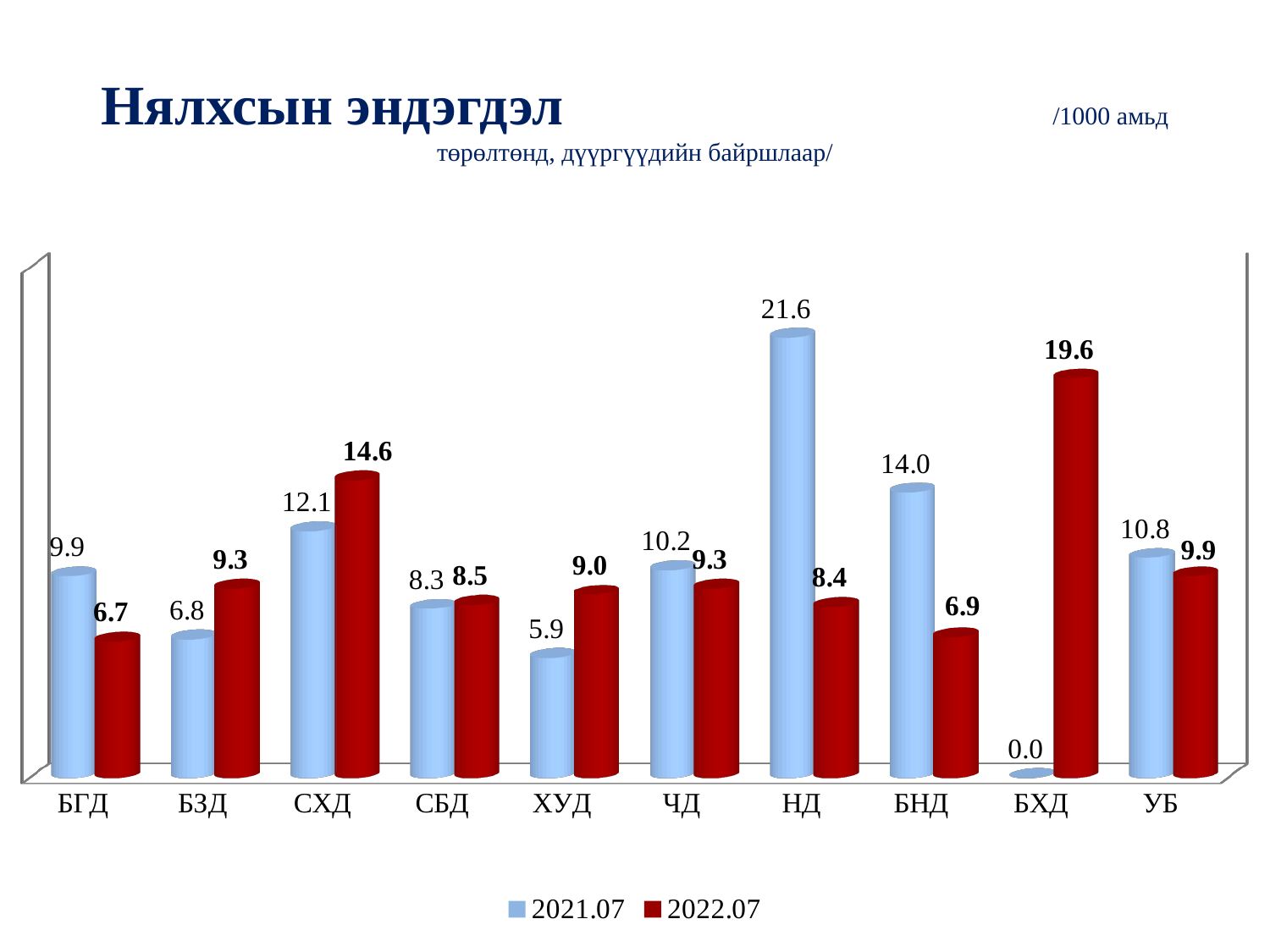
What is the value for БХД in the 2022.07 series? 19.6 Which is larger for БНД: the 2021.07 value or the 2022.07 value? 2021.07 What is the difference between the 2021.07 and 2022.07 values for НД? 13.2 Which category has the lowest value in the 2022.07 series? БГД How many series does the legend list? 2 How many categories are shown on the x axis? 10 What is the value for ХУД in the 2021.07 series? 5.9 What kind of chart is shown on the slide? Bar chart Which series is shown in dark red in the legend? 2022.07 What is the value for СХД in the 2022.07 series? 14.6 What is the value for НД in the 2021.07 series? 21.6 Which category has the highest value in the 2021.07 series? НД